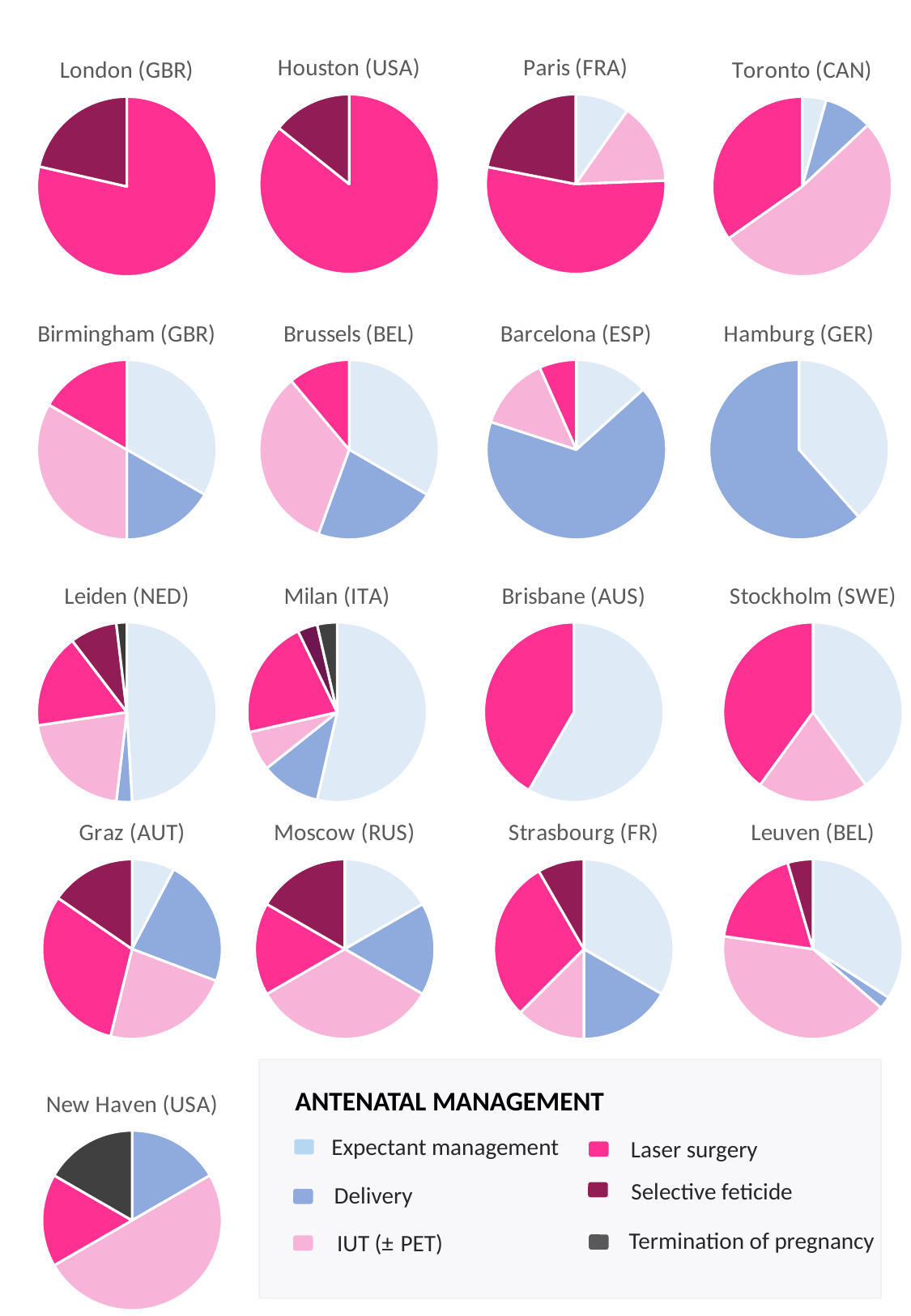
What is the title of the legend? ANTENATAL MANAGEMENT In the Stockholm (SWE) pie chart, which slice is larger: Laser surgery or IUT (± PET)? Laser surgery What colour represents Termination of pregnancy in the legend? dark grey In the Hamburg (GER) pie chart, which category has the largest slice? Delivery In the Toronto (CAN) pie chart, which category has the largest slice? IUT (± PET) What kind of chart is used for London (GBR)? pie chart In the Barcelona (ESP) pie chart, which category has the largest slice? Delivery How many categories are shown in the Houston (USA) pie chart? 2 In the Leuven (BEL) pie chart, which category has the smallest slice? Delivery How many pie charts are shown on the slide? 17 How many categories does the legend list? 6